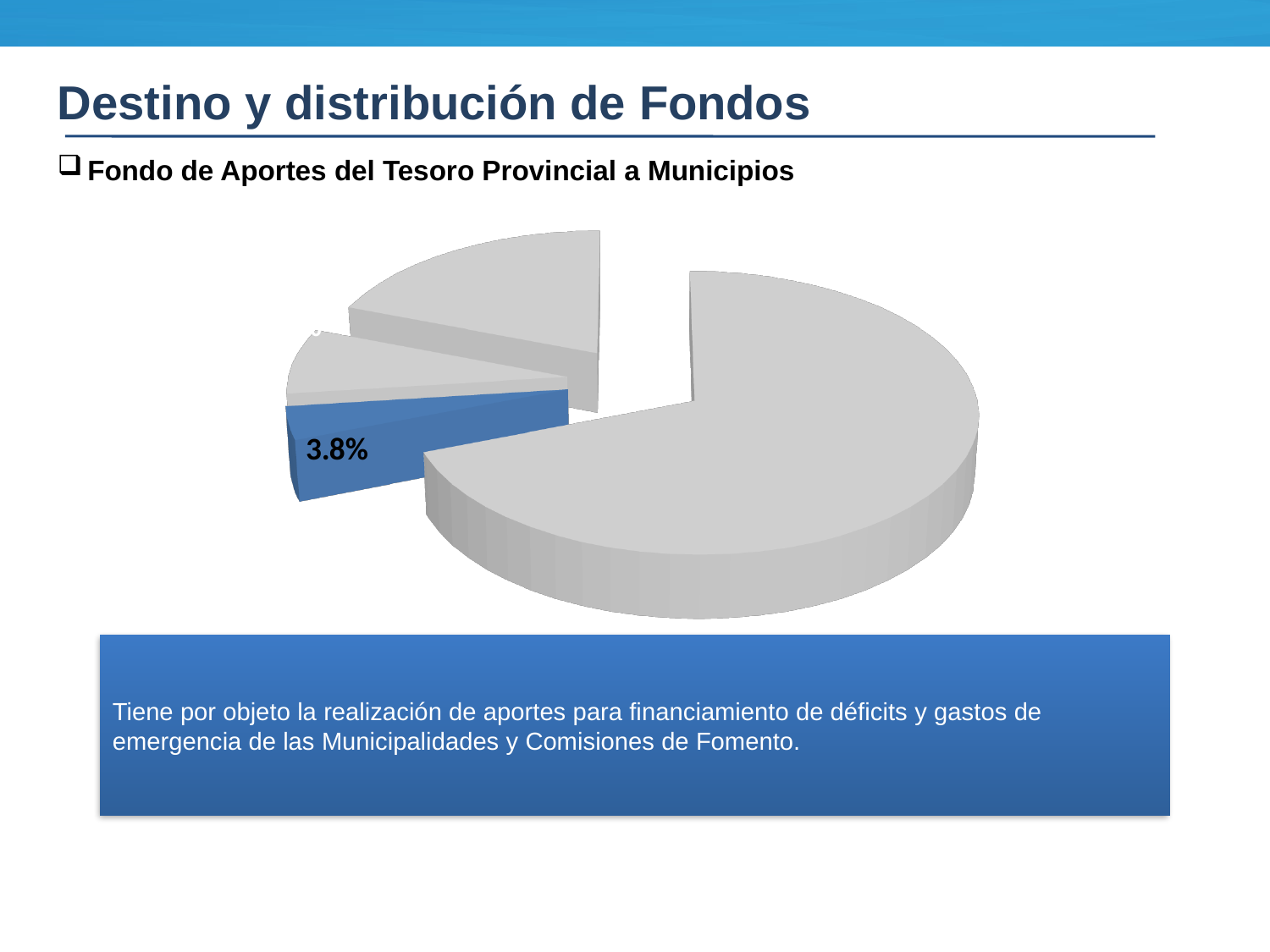
Is the blue slice of the pie chart larger or smaller than the large grey slice? smaller Which slice of the pie chart is the smallest? the blue slice (3.8%) Is the share of the blue slice in the pie chart greater or less than 10%? less What colour is the slice labelled 3.8% in the pie chart? blue What percentage is printed on the blue slice of the pie chart? 3.8% What kind of chart is shown on the slide? pie chart Which slice of the pie chart is the largest? the large grey slice How many slices does the pie chart have? 4